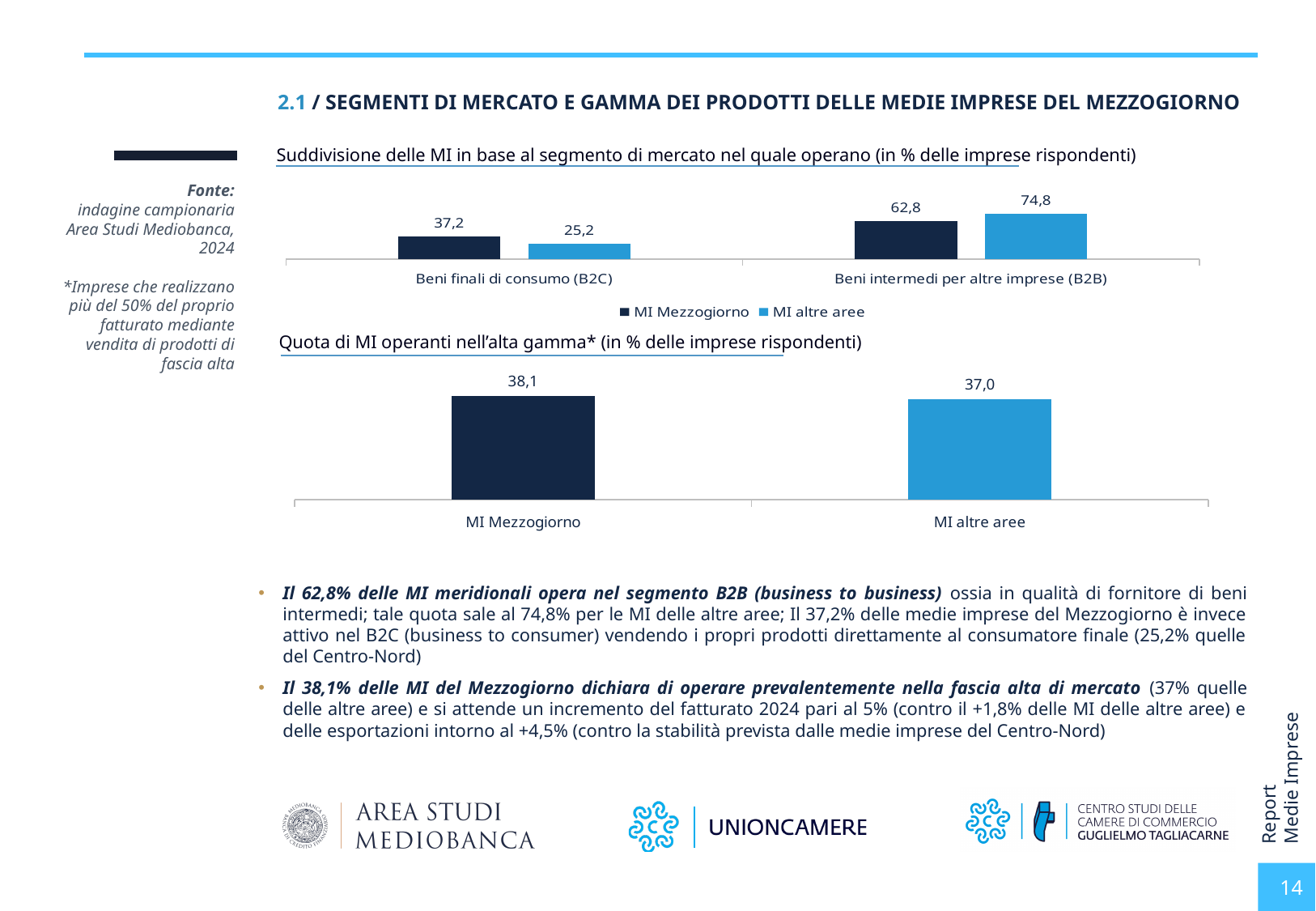
In the top chart (Suddivisione delle MI in base al segmento di mercato), what is the value for MI Mezzogiorno in Beni intermedi per altre imprese (B2B)? 62,8 In the top chart (Suddivisione delle MI in base al segmento di mercato), what is the value for MI Mezzogiorno in Beni finali di consumo (B2C)? 37,2 What kind of chart is the bottom chart (Quota di MI operanti nell'alta gamma)? Bar chart In the top chart (Suddivisione delle MI in base al segmento di mercato), which bar has the lowest value? MI altre aree, Beni finali di consumo (B2C) In the top chart (Suddivisione delle MI in base al segmento di mercato), what is the difference between MI altre aree and MI Mezzogiorno in Beni intermedi per altre imprese (B2B)? 12,0 How many categories are shown on the x axis of the top chart (Suddivisione delle MI in base al segmento di mercato)? 2 In the bottom chart (Quota di MI operanti nell'alta gamma), what is the value for MI Mezzogiorno? 38,1 How many series does the legend of the top chart (Suddivisione delle MI in base al segmento di mercato) list? 2 In the top chart (Suddivisione delle MI in base al segmento di mercato), what is the value for MI altre aree in Beni intermedi per altre imprese (B2B)? 74,8 In the bottom chart (Quota di MI operanti nell'alta gamma), what is the difference between MI Mezzogiorno and MI altre aree? 1,1 In the top chart (Suddivisione delle MI in base al segmento di mercato), which is larger in Beni finali di consumo (B2C): MI Mezzogiorno or MI altre aree? MI Mezzogiorno In the top chart (Suddivisione delle MI in base al segmento di mercato), which bar has the highest value? MI altre aree, Beni intermedi per altre imprese (B2B)